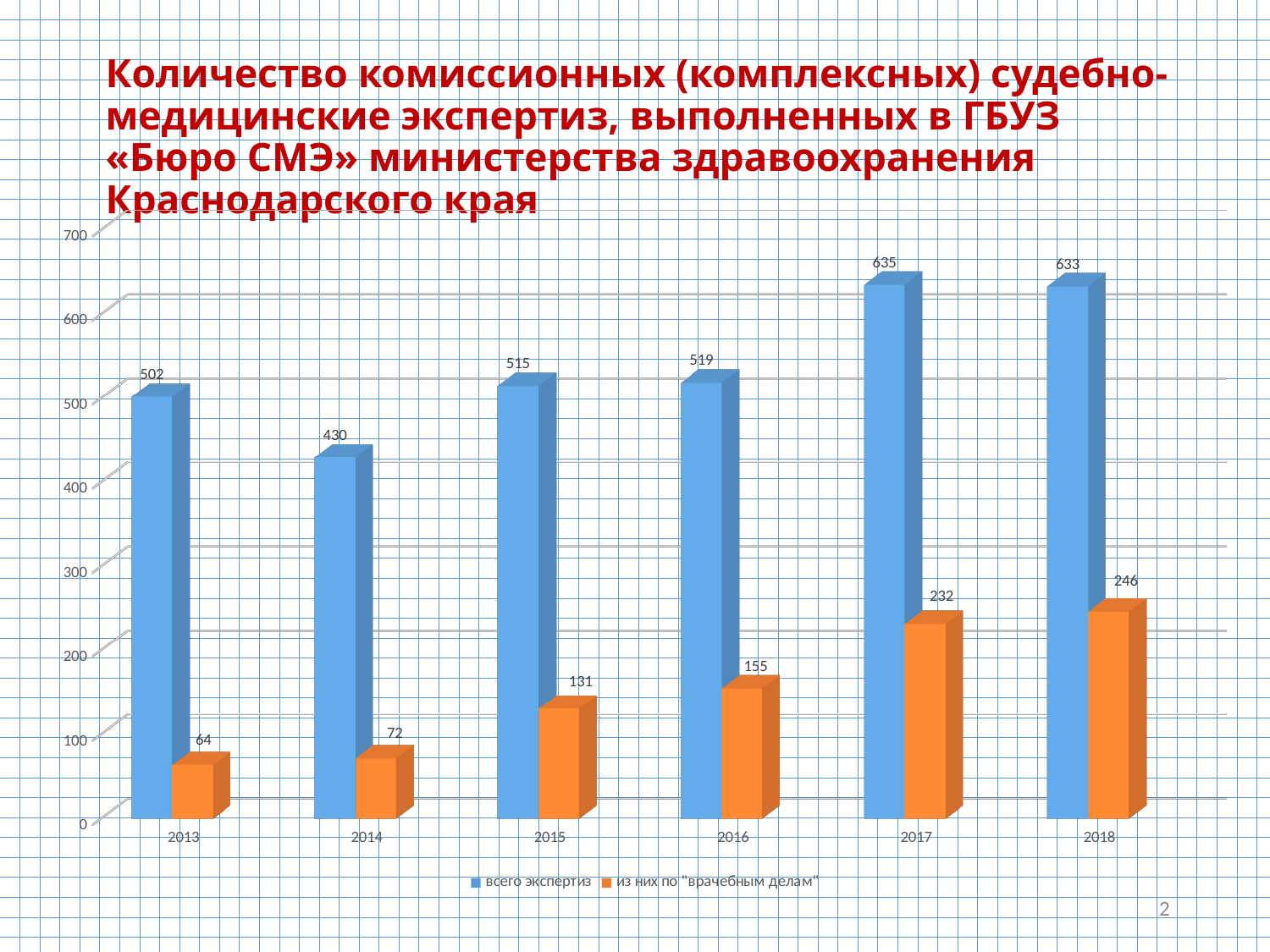
How many series does the legend list? 2 What colour are the bars for "всего экспертиз"? blue What is the value of "всего экспертиз" for 2015? 515 Is the value of "всего экспертиз" for 2016 greater or less than 500? greater What is the value of "из них по "врачебным делам"" for 2017? 232 Which is larger: "всего экспертиз" in 2013 or in 2014? 2013 How many years are shown on the x axis? 6 Which year has the highest value for "всего экспертиз"? 2017 What is the difference between "всего экспертиз" and "из них по "врачебным делам"" in 2018? 387 What kind of chart is shown on the slide? bar chart Which year has the lowest value for "из них по "врачебным делам""? 2013 Does the value of "из них по "врачебным делам"" rise or fall from 2013 to 2018? rise